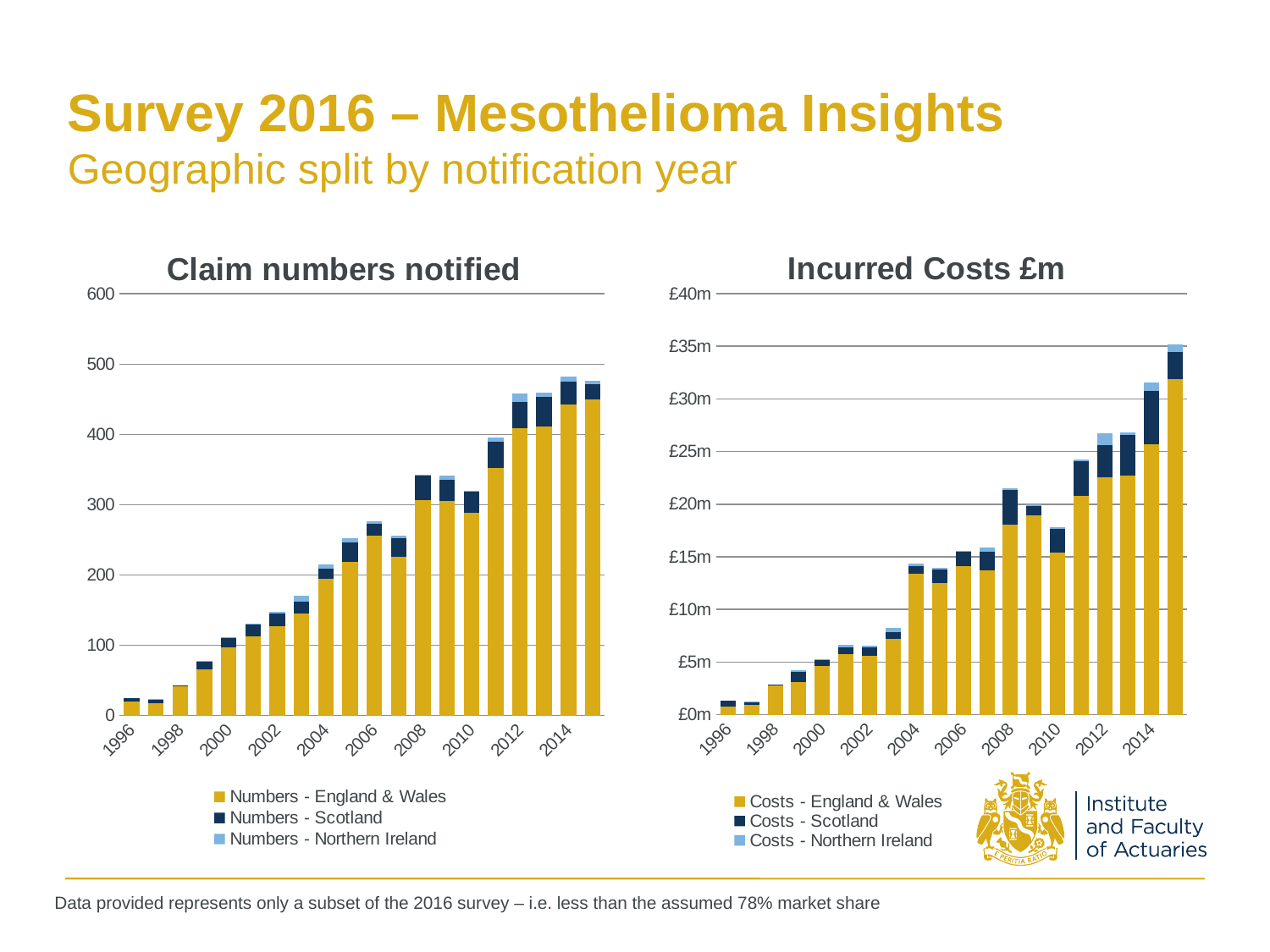
In the 'Claim numbers notified' chart, is the total for 1998 greater or less than 100? less What kind of chart is the 'Claim numbers notified' chart? Stacked bar chart In the 'Claim numbers notified' chart, which series is shown in the gold/yellow colour? Numbers - England & Wales In the 'Claim numbers notified' chart, do the totals generally rise or fall from 1996 to 2015? Rise In the 'Claim numbers notified' chart, which year has the larger total: 2004 or 2008? 2008 In the 'Incurred Costs £m' chart, is the total for 2004 greater or less than £15m? less In the 'Incurred Costs £m' chart, which series is shown in the light blue colour? Costs - Northern Ireland In the 'Incurred Costs £m' chart, which year has the highest total incurred cost? 2015 In the 'Claim numbers notified' chart, is the total for 2012 greater or less than 400? greater How many series does the legend of the 'Incurred Costs £m' chart list? 3 In the 'Incurred Costs £m' chart, which year has the larger total: 2009 or 2013? 2013